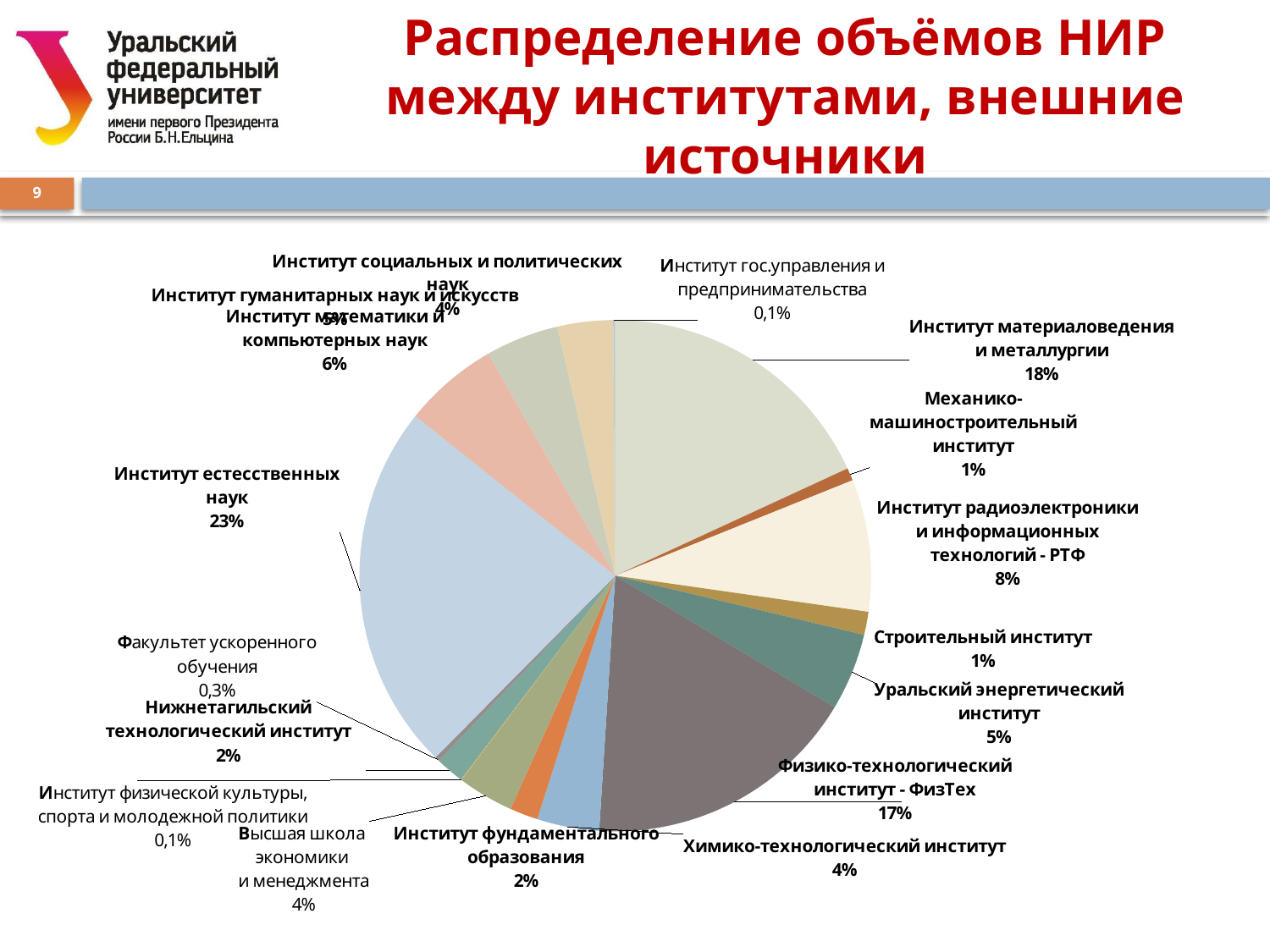
What share does Институт радиоэлектроники и информационных технологий - РТФ have? 8% Which institute has the largest share of the pie? Институт естесственных наук What is the difference in percentage points between Институт естесственных наук and Институт материаловедения и металлургии? 5 What share does Уральский энергетический институт have? 5% Which has a larger share: Институт математики и компьютерных наук or Химико-технологический институт? Институт математики и компьютерных наук What kind of chart is shown on the slide? pie chart What is the difference in percentage points between Физико-технологический институт - ФизТех and Уральский энергетический институт? 12 What share does Институт материаловедения и металлургии have? 18% What share does Факультет ускоренного обучения have? 0,3% What is the title of the slide containing the chart? Распределение объёмов НИР между институтами, внешние источники What share does Институт гос.управления и предпринимательства have? 0,1% What share does Физико-технологический институт - ФизТех have? 17%